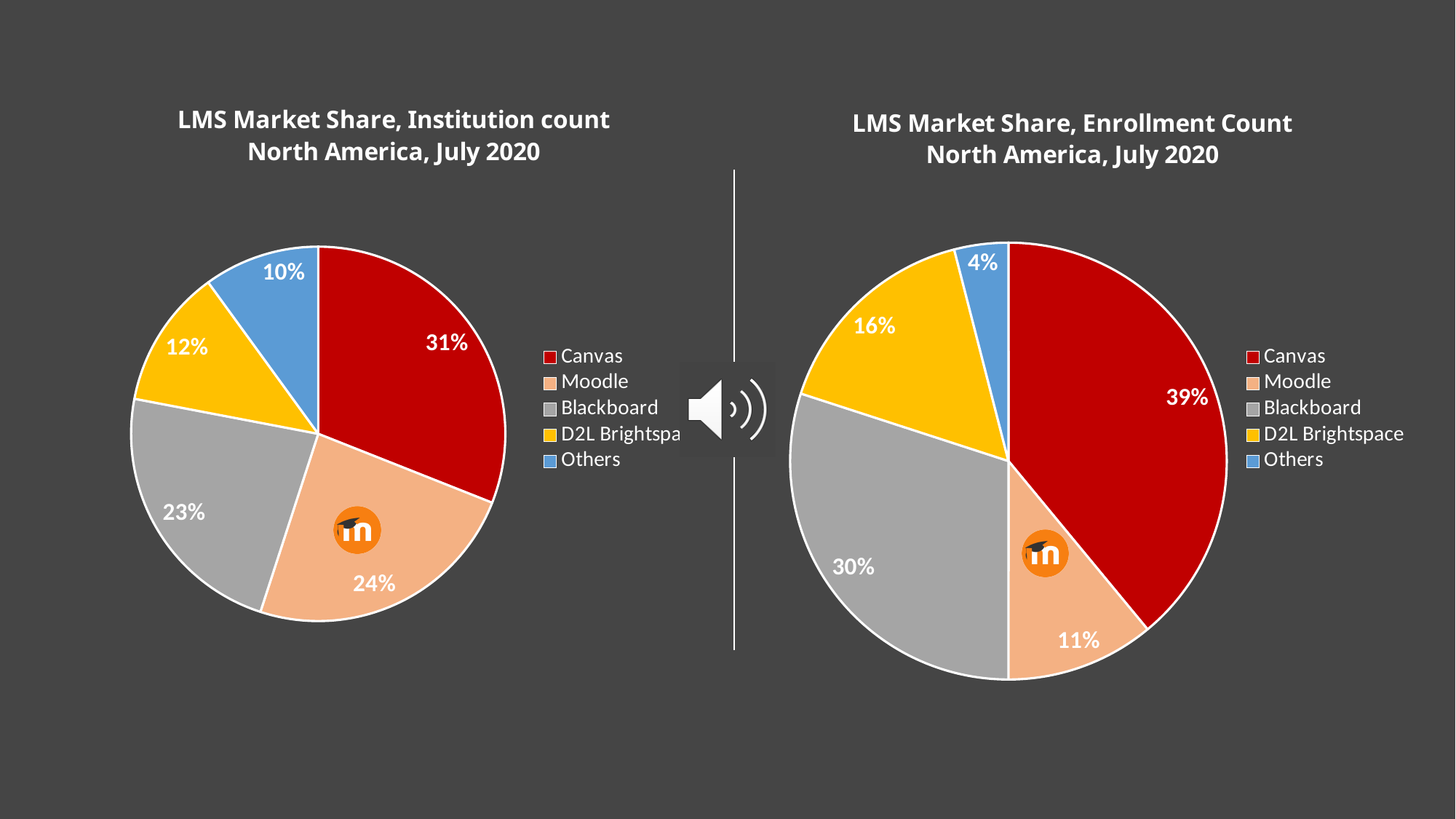
In the 'LMS Market Share, Institution count' chart, which category has the largest share? Canvas In the 'LMS Market Share, Institution count' chart, which colour represents Blackboard? Grey In the 'LMS Market Share, Institution count' chart, what share does Canvas have? 31% In the 'LMS Market Share, Enrollment Count' chart, what share does Others have? 4% In the 'LMS Market Share, Enrollment Count' chart, which is larger, the Moodle share or the D2L Brightspace share? D2L Brightspace In the 'LMS Market Share, Enrollment Count' chart, which category has the smallest share? Others In the 'LMS Market Share, Enrollment Count' chart, what share does Blackboard have? 30% What kind of chart is the 'LMS Market Share, Enrollment Count' chart? Pie chart In the 'LMS Market Share, Institution count' chart, what share does Moodle have? 24% In the 'LMS Market Share, Enrollment Count' chart, what is the difference between the Canvas share and the Moodle share? 28% In the 'LMS Market Share, Institution count' chart, what is the difference between the Blackboard share and the D2L Brightspace share? 11% How many slices does the 'LMS Market Share, Institution count' pie chart have? 5